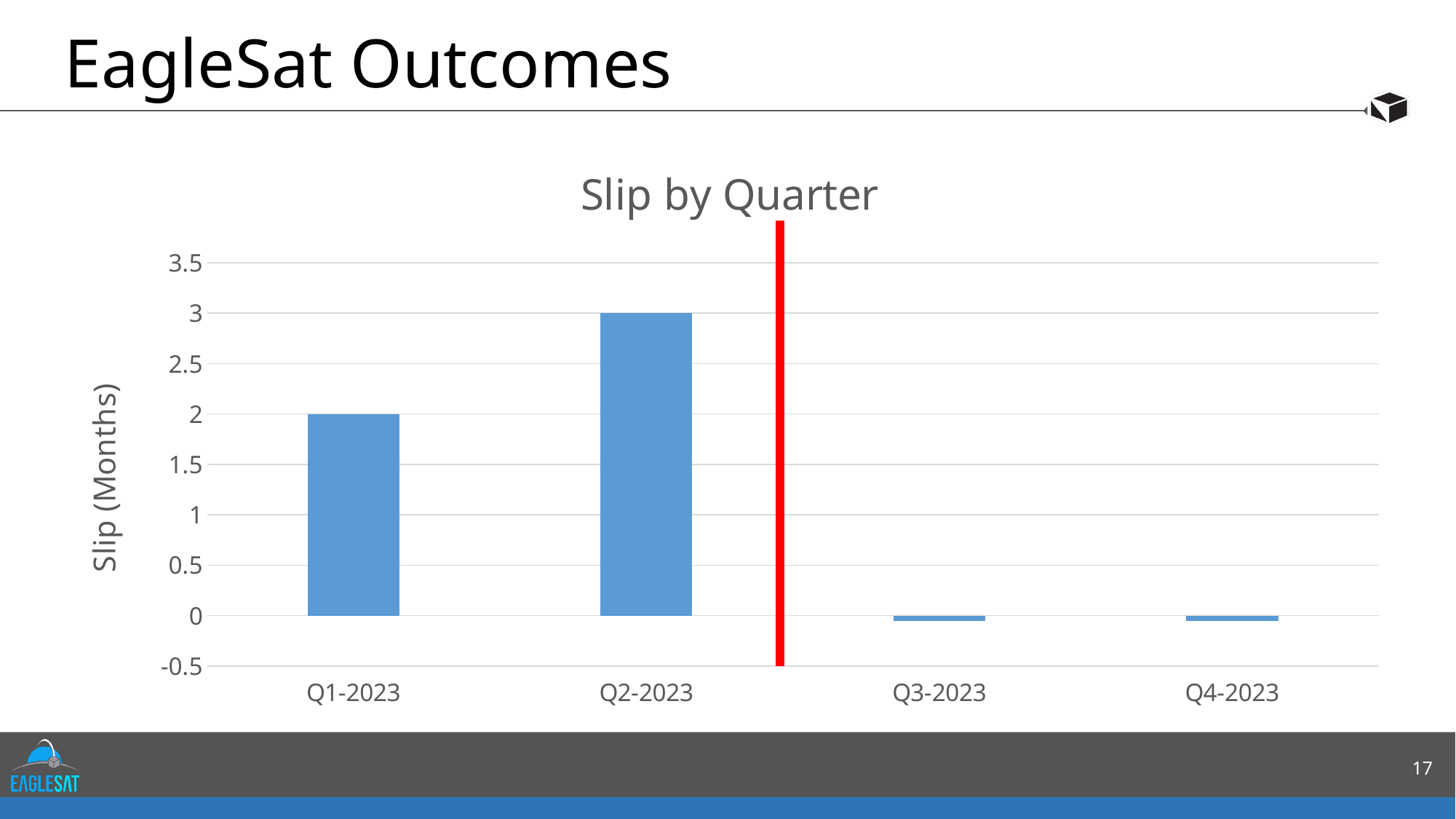
Is the value for Q3-2023 greater or less than 0.5? less Is the value for Q4-2023 greater or less than 1? less Which quarter has the highest slip? Q2-2023 What is the slip in months for Q2-2023? 3 What kind of chart is shown on the slide? bar chart Which has a larger slip, Q1-2023 or Q2-2023? Q2-2023 How many quarters are plotted on the x axis? 4 What is the slip in months for Q1-2023? 2 What is the label on the vertical axis? Slip (Months) What is the chart title? Slip by Quarter What is the difference in slip between Q2-2023 and Q1-2023? 1 Does the slip rise or fall from Q1-2023 to Q2-2023? rise